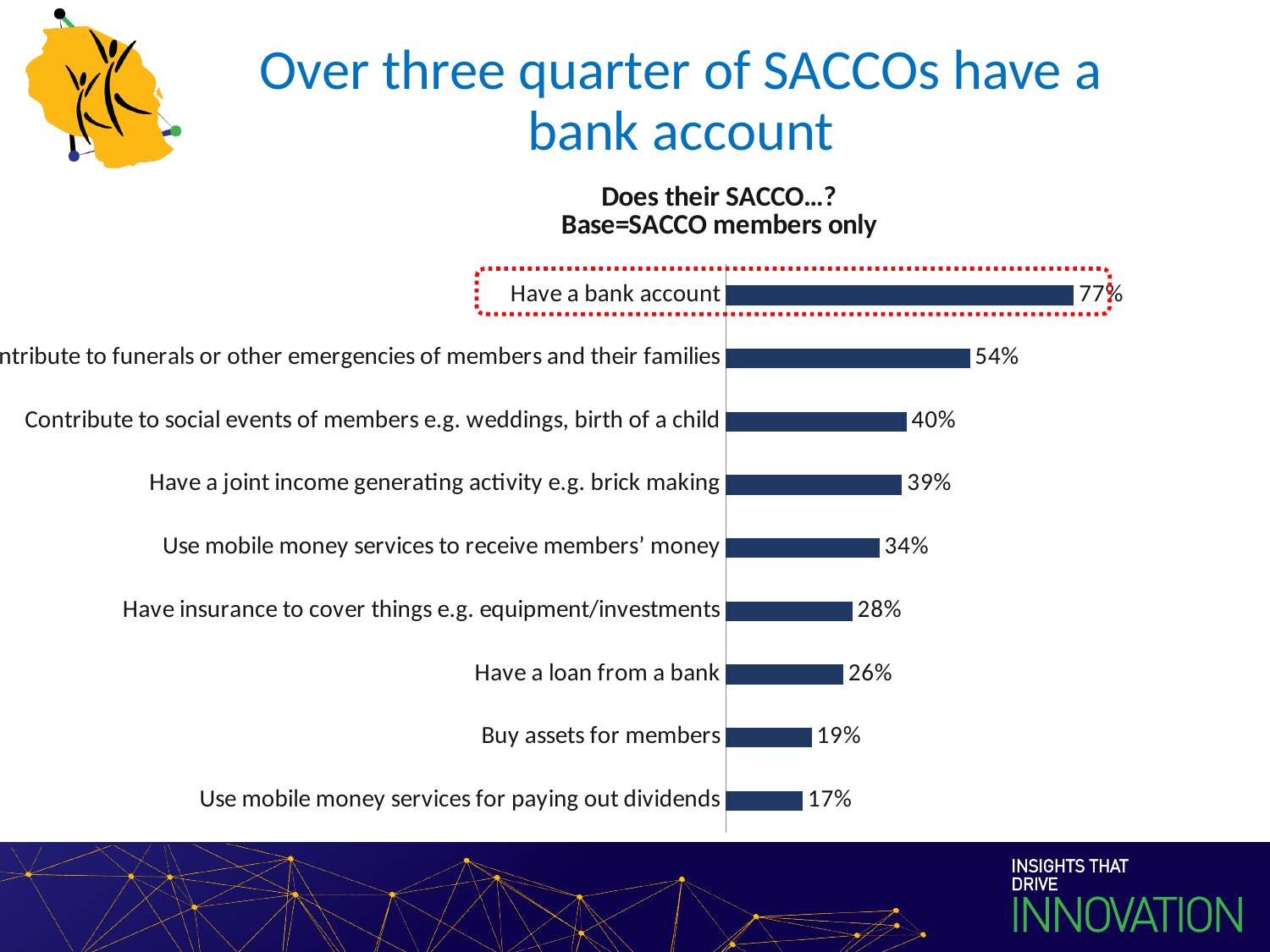
What is the value for 'Have insurance to cover things e.g. equipment/investments'? 28% What kind of chart is shown on the slide? Bar chart What is the value for 'Use mobile money services for paying out dividends'? 17% Which is larger: 'Use mobile money services to receive members' money' or 'Buy assets for members'? Use mobile money services to receive members' money What is the value for 'Have a loan from a bank'? 26% What is the difference between 'Have a bank account' and 'Have a loan from a bank'? 51% How many categories are shown in the chart? 9 Which category has the highest value? Have a bank account What is the chart's title? Does their SACCO...? Base=SACCO members only What is the difference between 'Contribute to social events of members e.g. weddings, birth of a child' and 'Have a joint income generating activity e.g. brick making'? 1% What percentage of SACCOs have a bank account? 77% Which category has the lowest value? Use mobile money services for paying out dividends